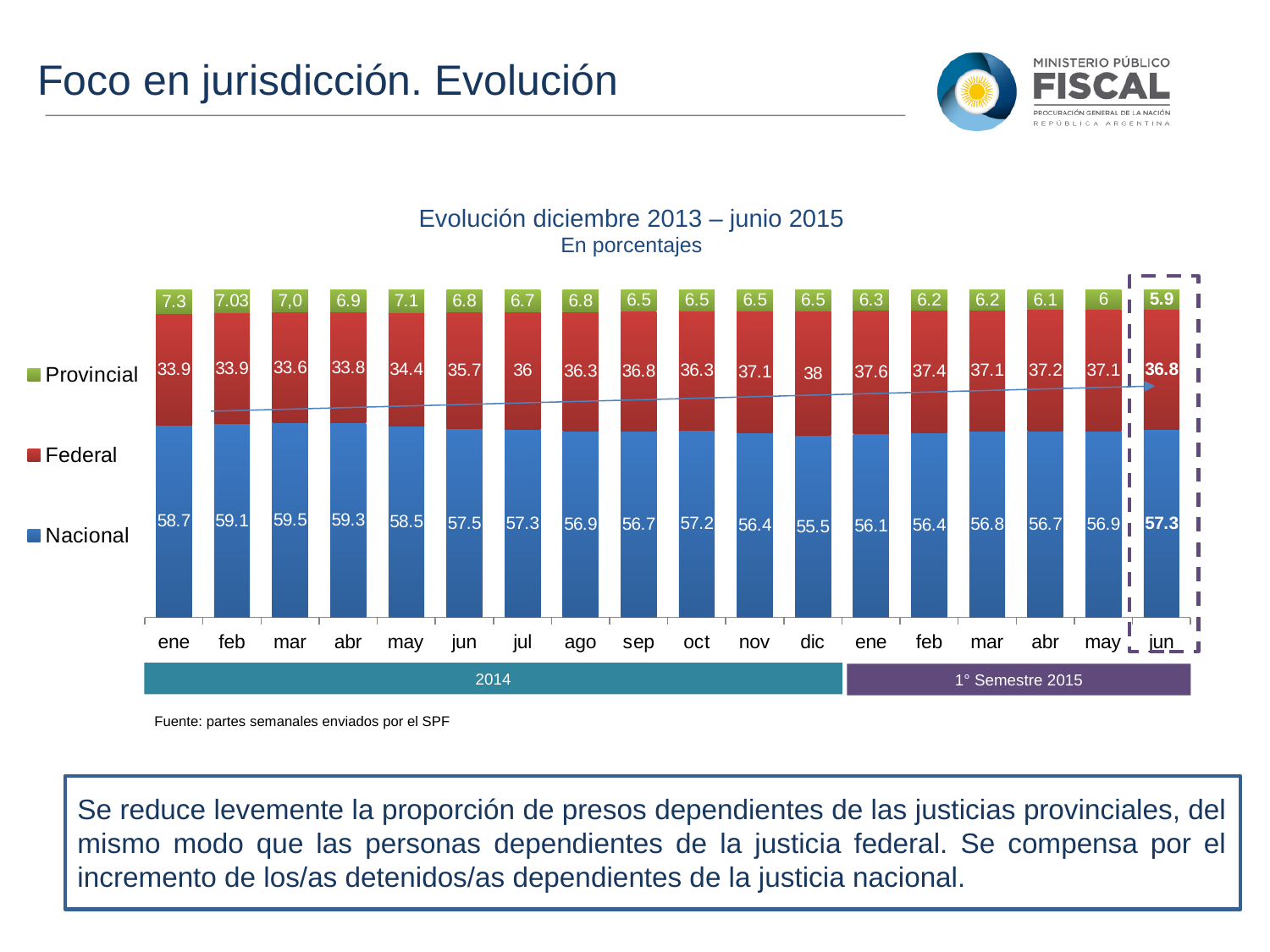
What is the difference between the Nacional value for mar 2014 and dic 2014? 4 How many series does the legend list? 3 What is the title of the chart? Evolución diciembre 2013 – junio 2015 Which is larger, the Federal value for may 2014 or the Federal value for may 2015? may 2015 What is the Provincial value for ene 2014? 7.3 How many months (bars) are plotted in the chart? 18 What is the Nacional value for dic 2014? 55.5 What is the Federal value for jun 2015? 36.8 Does the Provincial series rise or fall from ene 2014 to jun 2015? fall In which month is the Provincial value lowest? jun 2015 What type of chart is shown on the slide? stacked bar chart In which month is the Federal value highest? dic 2014